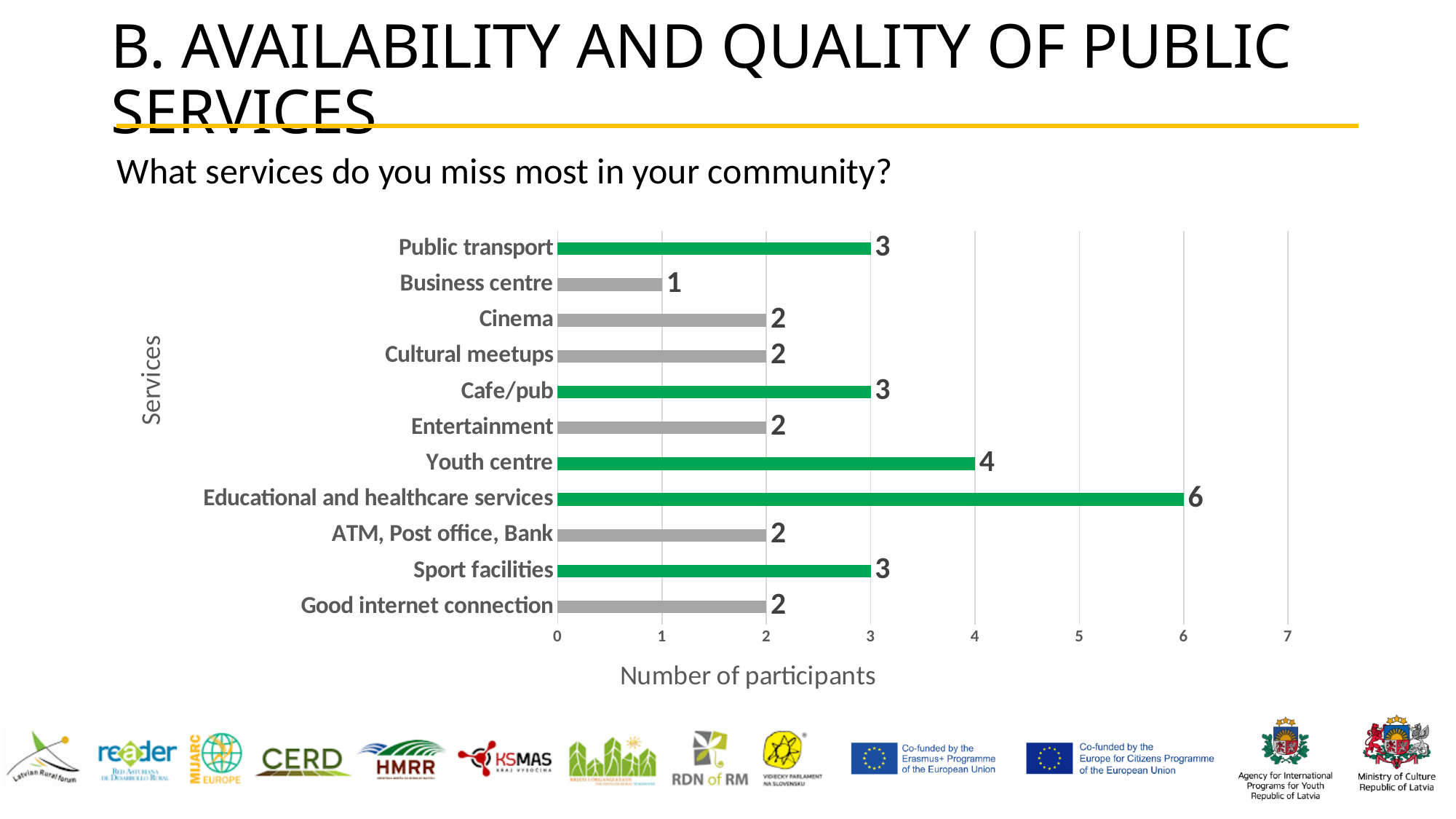
What is the number of participants for Youth centre? 4 Which service has the lowest number of participants? Business centre What is the number of participants for Cafe/pub? 3 Which service has the highest number of participants? Educational and healthcare services What is the difference in number of participants between Educational and healthcare services and Youth centre? 2 What kind of chart is shown on the slide? Bar chart What is the number of participants for Business centre? 1 How many services are listed in the chart? 11 Which has more participants, Public transport or Cinema? Public transport What is the label of the vertical axis of the chart? Services What is the label of the horizontal axis of the chart? Number of participants What is the number of participants for Educational and healthcare services? 6